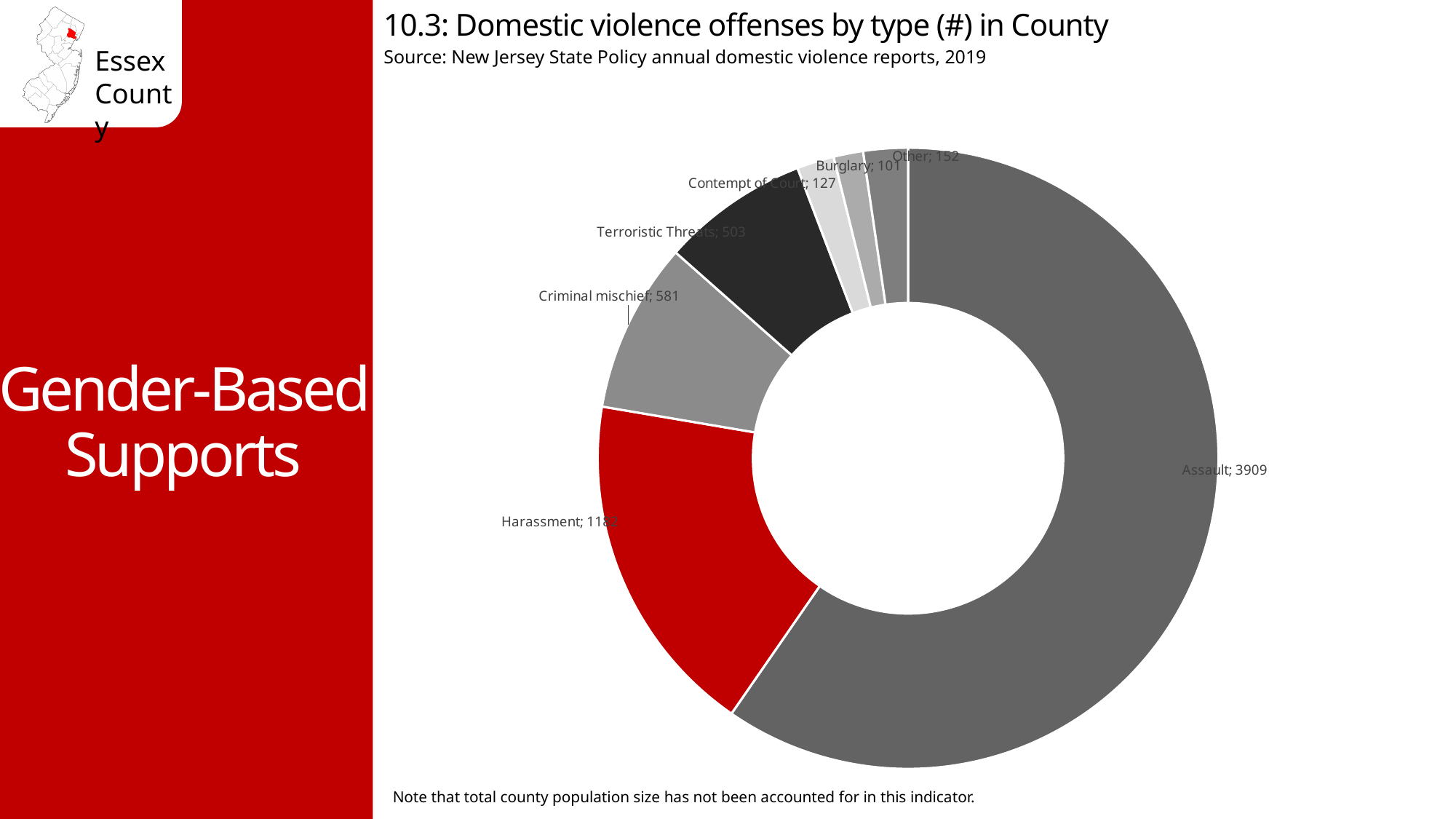
What is the number of Terroristic Threats offenses shown in the chart? 503 What type of chart is shown on the slide? Doughnut (pie) chart Which slice of the chart is coloured red? Harassment Which has more offenses, Criminal mischief or Terroristic Threats? Criminal mischief What is the number of Assault offenses shown in the chart? 3909 What is the difference between the number of Assault offenses and Criminal mischief offenses? 3328 What is the number of Criminal mischief offenses shown in the chart? 581 Which offense type has the lowest number of offenses? Burglary What is the difference between the number of Other offenses and Burglary offenses? 51 Which offense type has the highest number of offenses? Assault How many offense types are shown in the chart? 7 What is the number of Burglary offenses shown in the chart? 101